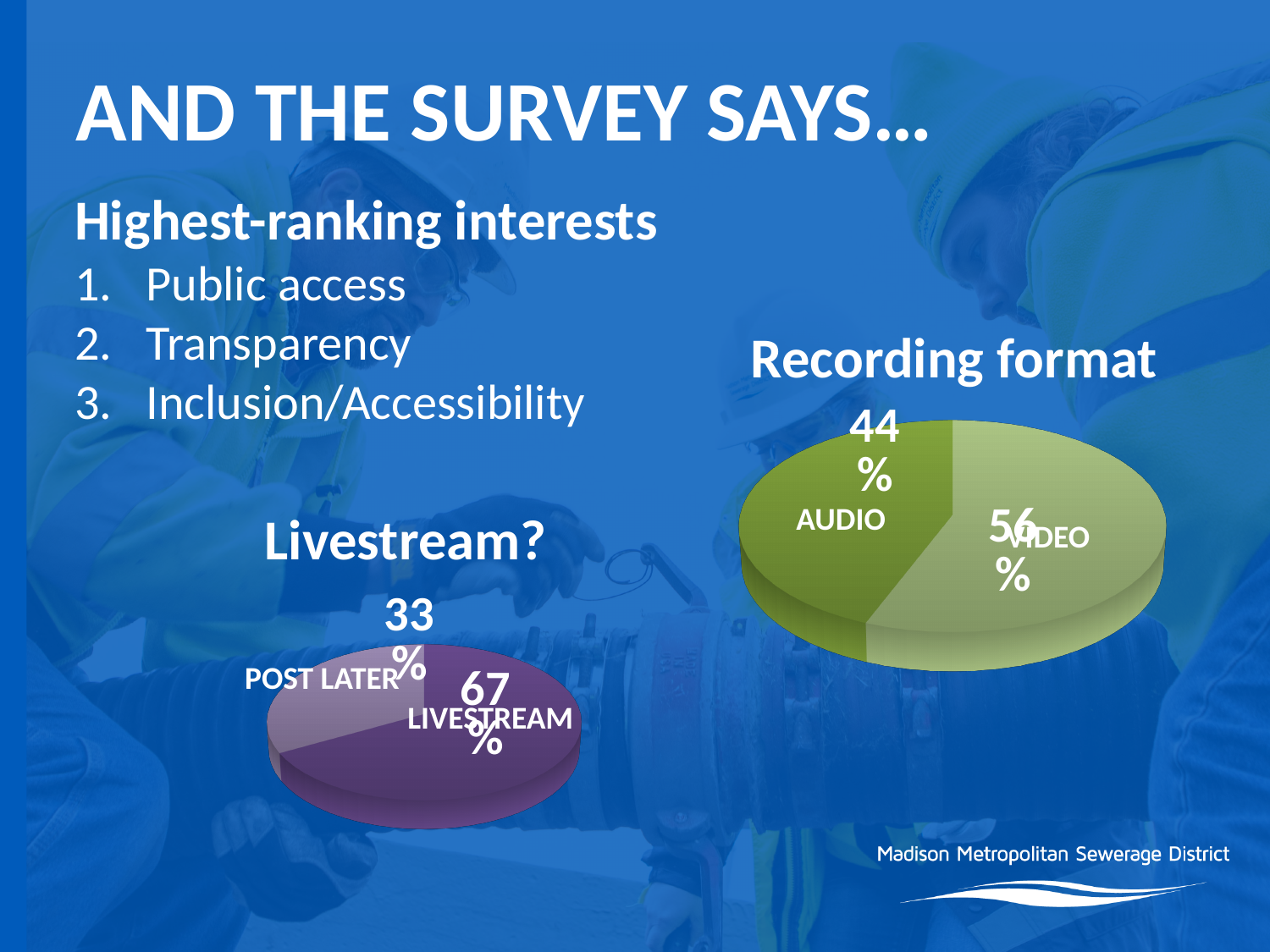
In the "Livestream?" chart, what is the difference in percentage points between LIVESTREAM and POST LATER? 34 In the "Livestream?" chart, what percentage is shown for POST LATER? 33% What is the title of the chart on the right side of the slide? Recording format In the "Recording format" chart, what percentage is shown for AUDIO? 44% In the "Livestream?" chart, what percentage is shown for LIVESTREAM? 67% In the "Recording format" chart, what percentage is shown for VIDEO? 56% In the "Recording format" chart, which is larger, AUDIO or VIDEO? VIDEO In the "Recording format" chart, what is the difference in percentage points between VIDEO and AUDIO? 12 What kind of chart is the "Recording format" chart? Pie chart In the "Recording format" chart, which slice is the smallest? AUDIO In the "Livestream?" chart, which slice is the largest? LIVESTREAM How many slices does the "Livestream?" chart have? 2